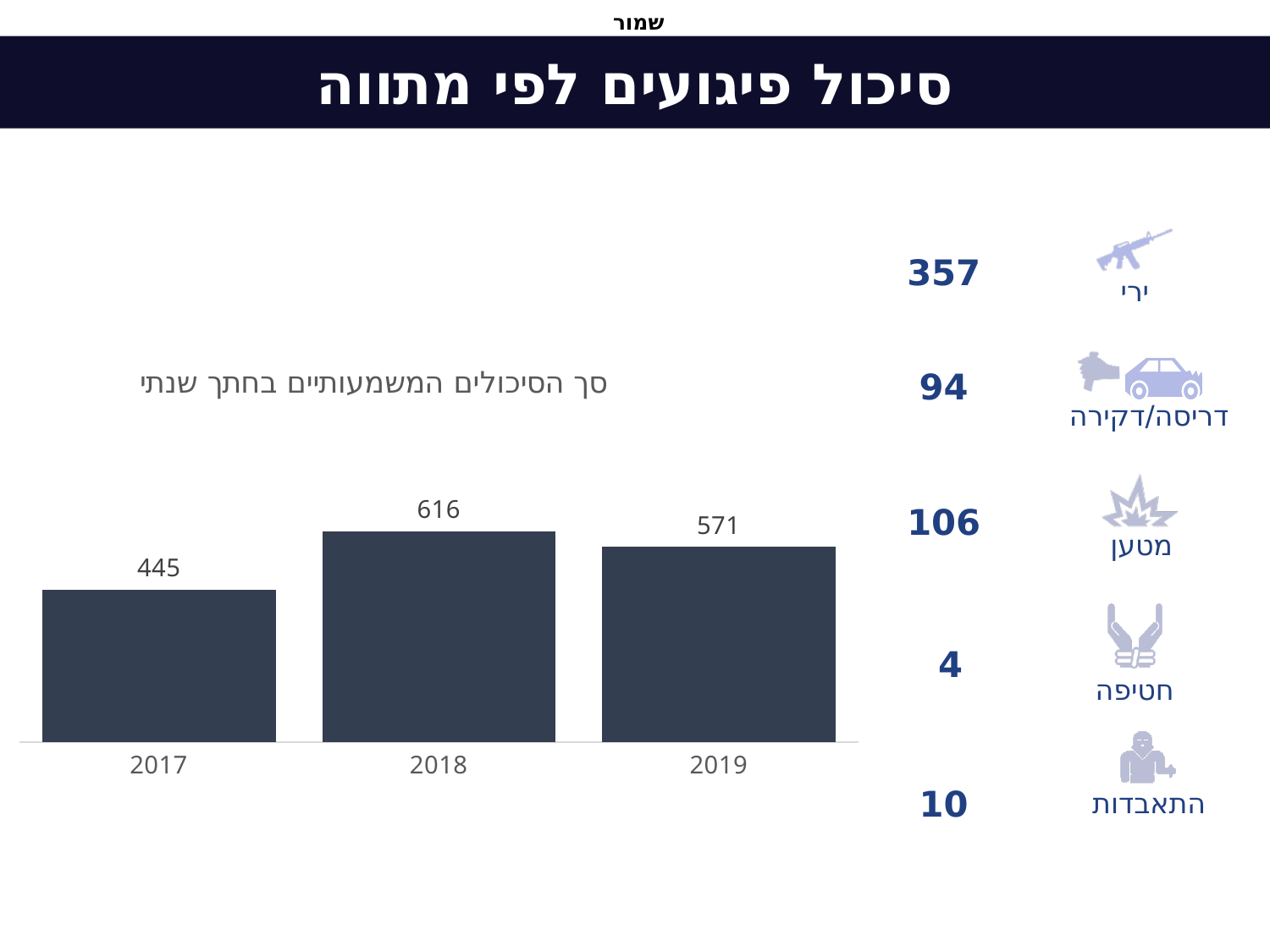
How many years are shown in the bar chart? 3 Which year has the highest value in the bar chart? 2018 What is the value for 2018 in the bar chart? 616 What is the value for 2019 in the bar chart? 571 What is the title of the bar chart? סך הסיכולים המשמעותיים בחתך שנתי What is the value for 2017 in the bar chart? 445 Does the value rise or fall from 2018 to 2019 in the bar chart? fall Which is larger in the bar chart, the value for 2019 or the value for 2017? 2019 What kind of chart is shown on the slide? bar chart What is the difference between the values for 2018 and 2019 in the bar chart? 45 What is the difference between the values for 2018 and 2017 in the bar chart? 171 Which year has the lowest value in the bar chart? 2017